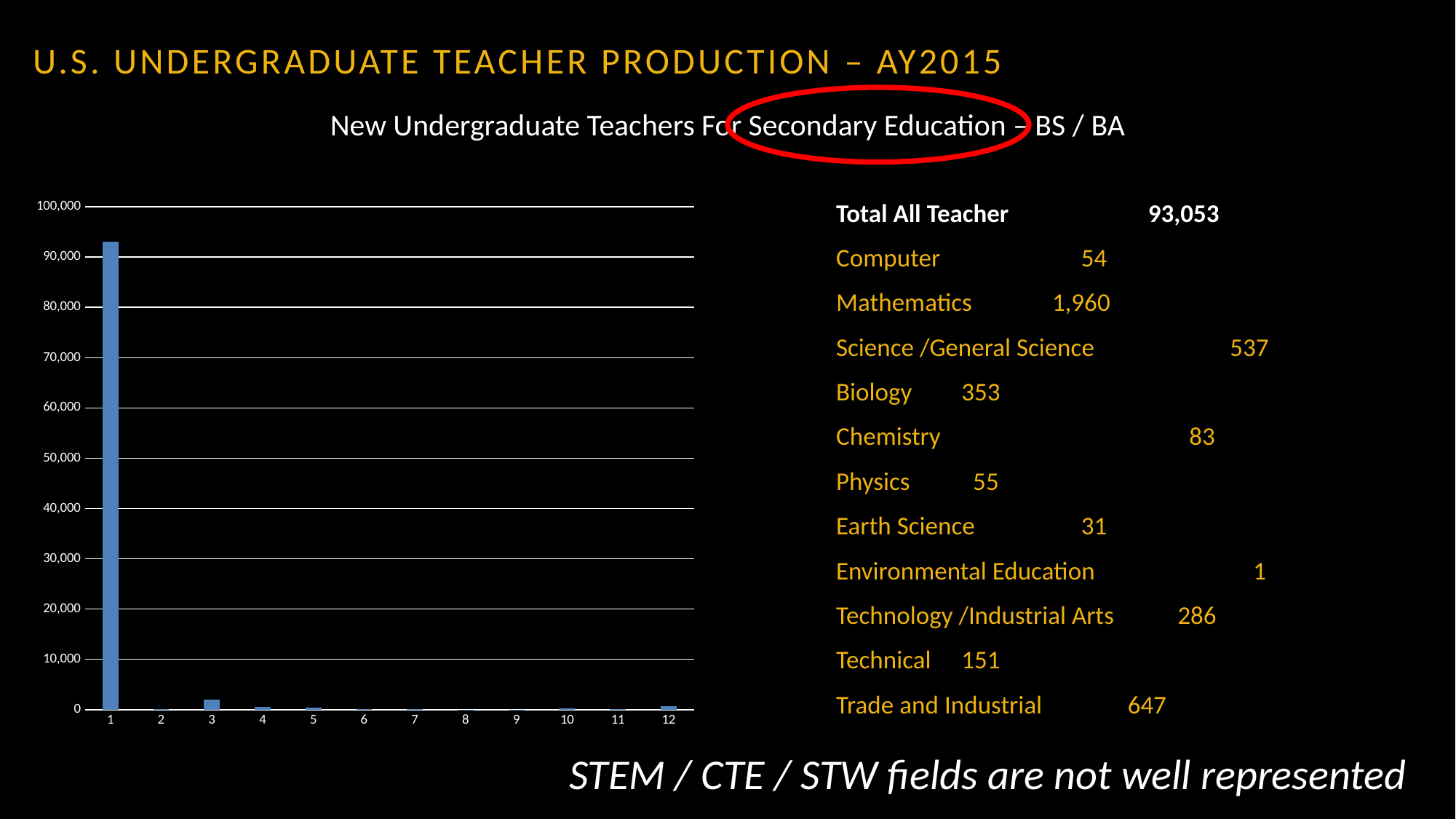
What is the highest value shown on the chart's y axis? 100,000 What is the title of the chart? New Undergraduate Teachers For Secondary Education – BS / BA Is the value for category 3 greater or less than 10,000? less Which category has the highest bar in the chart? 1 How many categories are shown on the x axis of the chart? 12 Which is larger, the value for category 3 or the value for category 2? category 3 What kind of chart is shown on the slide? bar chart Which is larger, the value for category 1 or the value for category 3? category 1 Is the value for category 12 greater or less than 10,000? less Is the value for category 1 greater or less than 80,000? greater